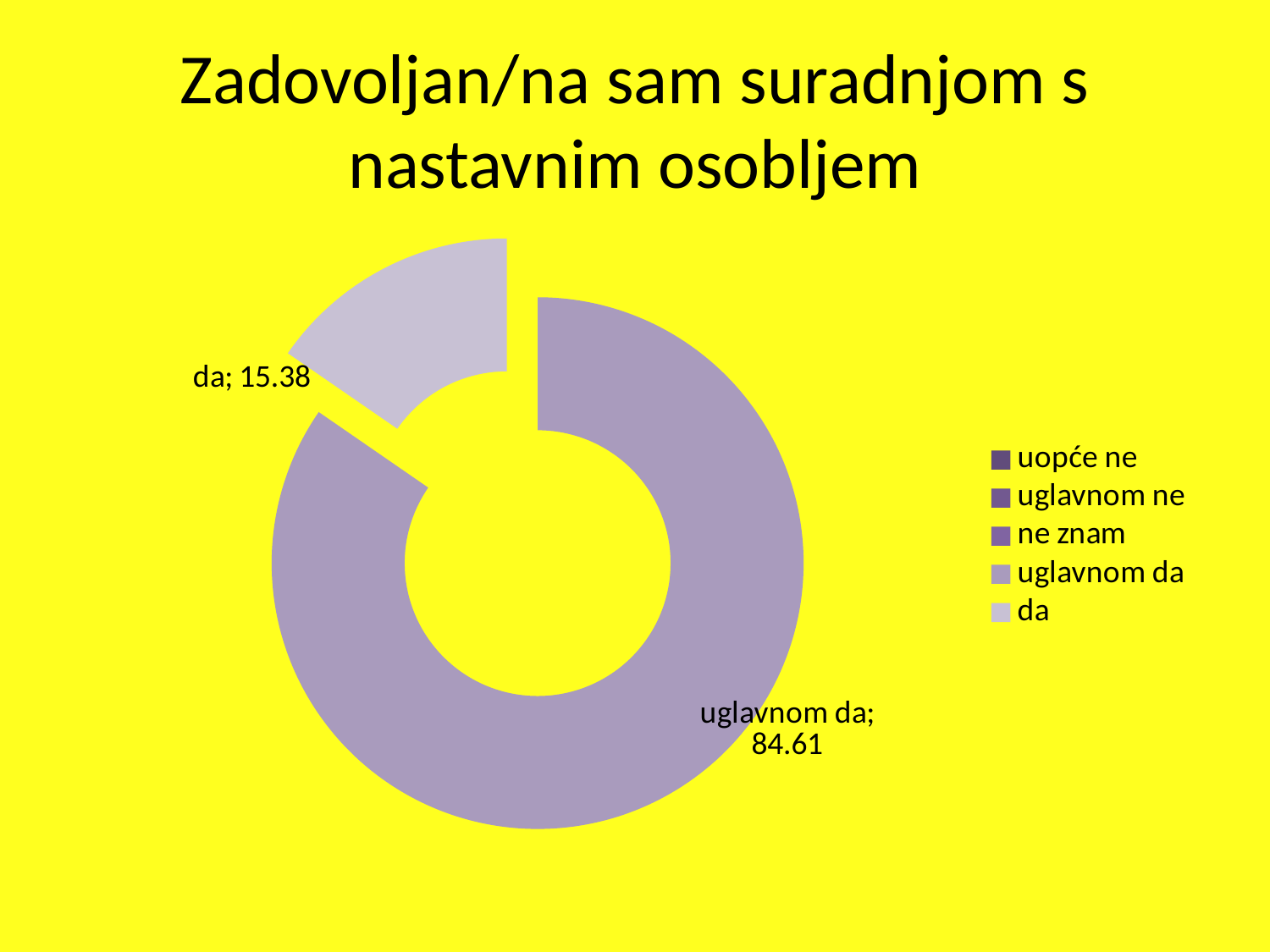
How many slices with data labels are shown in the chart? 2 What is the value shown for the 'uglavnom da' slice? 84.61 Which is larger, the 'da' slice or the 'uglavnom da' slice? uglavnom da Which of the labelled slices is the smallest? da Which slice of the chart is the largest? uglavnom da What kind of chart is shown on the slide? doughnut (pie) chart What is the difference between the values for 'uglavnom da' and 'da'? 69.23 How many entries does the legend list? 5 What is the value shown for the 'da' slice? 15.38 What is the title of the slide? Zadovoljan/na sam suradnjom s nastavnim osobljem Which legend entry is listed first? uopće ne